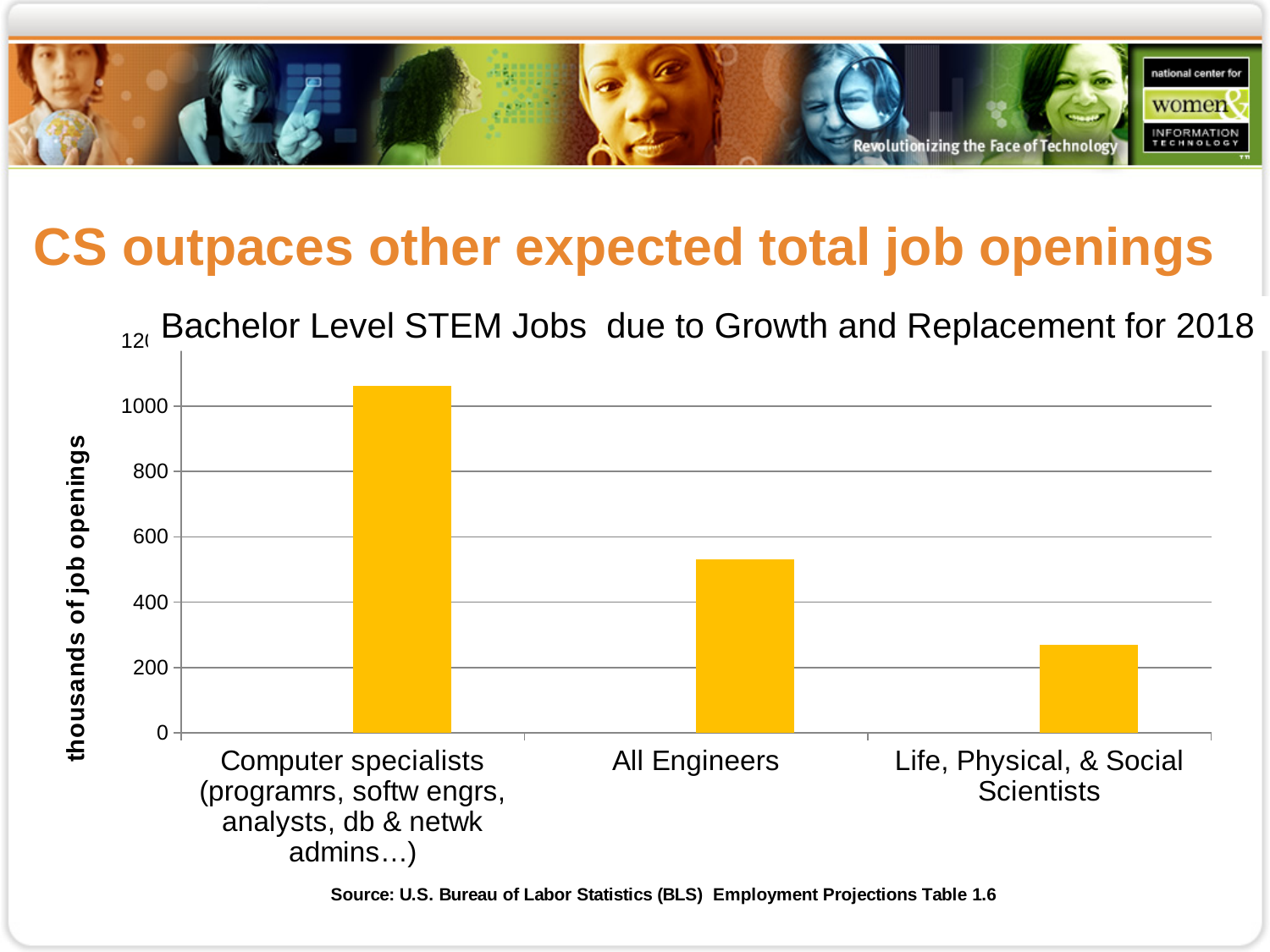
What kind of chart is shown on the slide? bar chart Which has more job openings, Computer specialists or All Engineers? Computer specialists Is the value for All Engineers greater or less than 600? less What is the title of the chart? Bachelor Level STEM Jobs due to Growth and Replacement for 2018 Is the value for Life, Physical, & Social Scientists greater or less than 400? less Which category has the highest number of job openings? Computer specialists How many categories are plotted in the chart? 3 Is the value for Computer specialists greater or less than 1000? greater What is the label of the vertical axis? thousands of job openings Which has more job openings, All Engineers or Life, Physical, & Social Scientists? All Engineers Which category has the lowest number of job openings? Life, Physical, & Social Scientists